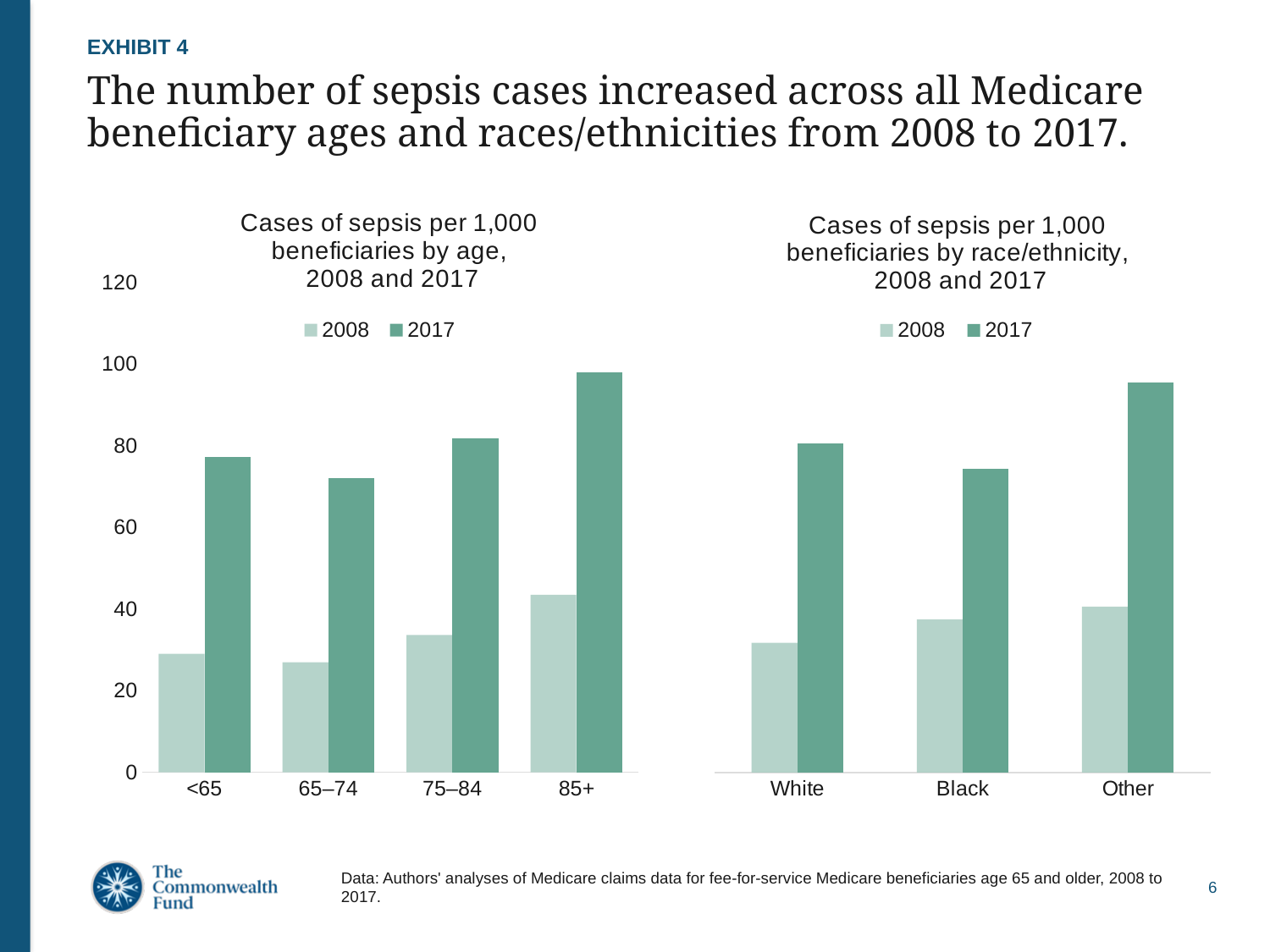
In the left chart (by age), is the 2017 value for 85+ greater or less than 80? greater In the right chart (by race/ethnicity), which group has the lowest value for 2008? White In the right chart (by race/ethnicity), which group has the highest value for 2017? Other In the right chart (by race/ethnicity), how many series does the legend list? 2 In the left chart (by age), is the 2017 value for 65–74 greater or less than 60? greater In the right chart (by race/ethnicity), is the 2008 value for White greater or less than 40? less In the left chart (by age), how many age categories are shown on the x axis? 4 In the left chart (by age), which is larger for 2017: 65–74 or 75–84? 75–84 In the right chart (by race/ethnicity), which is larger for 2017: White or Black? White In the left chart (by age), which age group has the highest value for 2017? 85+ What kind of chart is the left chart, 'Cases of sepsis per 1,000 beneficiaries by age, 2008 and 2017'? Bar chart What is the title of the right chart? Cases of sepsis per 1,000 beneficiaries by race/ethnicity, 2008 and 2017